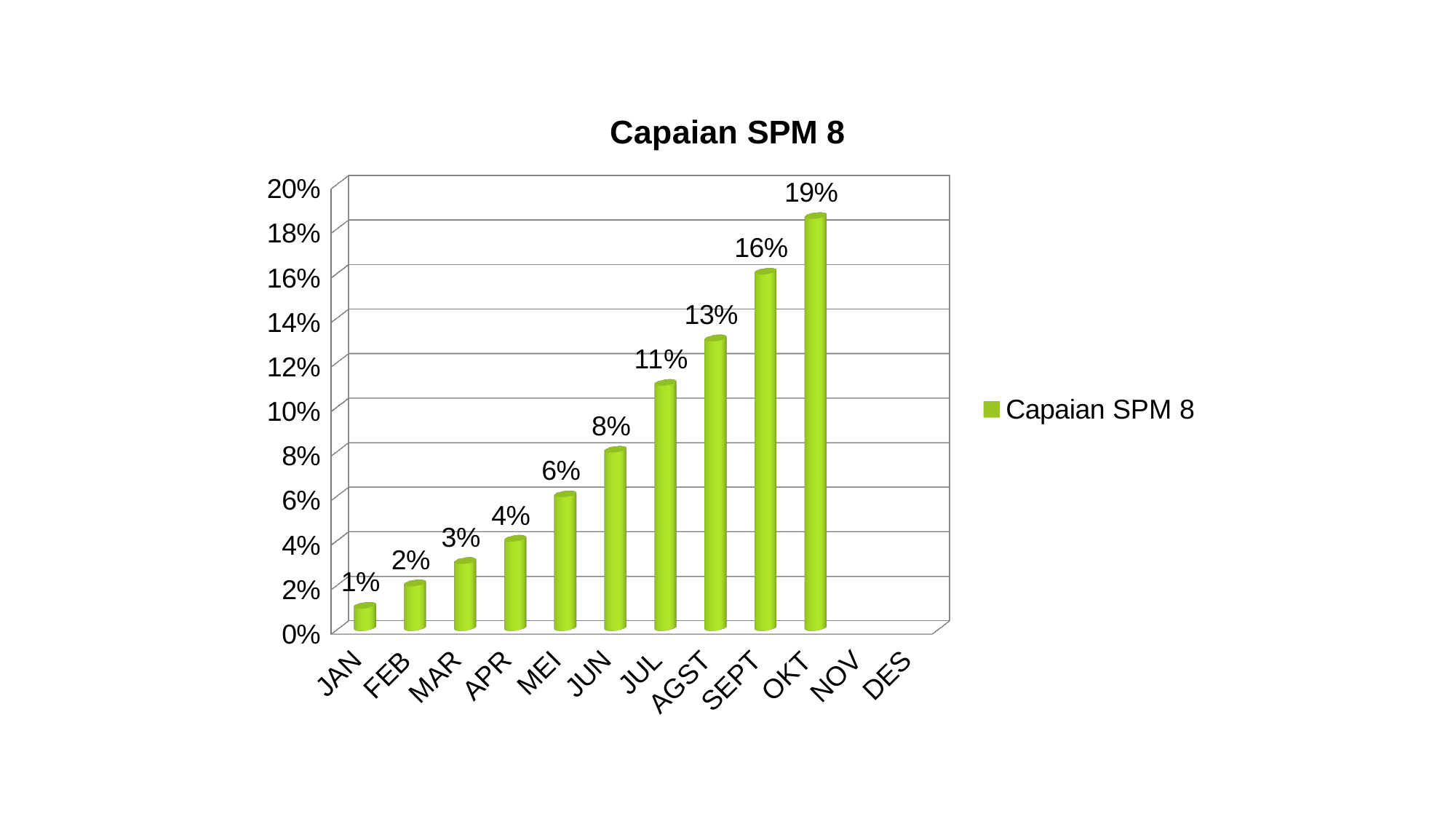
Which is larger, the value for JUN or the value for APR? JUN What is the value for MEI? 6% How many series does the legend list? 1 How many month categories are shown on the x axis? 12 Is the value for AGST greater or less than 10%? greater What is the difference between the values for OKT and AGST? 6% What is the value for JUL? 11% What is the value for SEPT? 16% What kind of chart is shown? bar chart Do the values rise or fall from JAN to OKT? rise Which month with a plotted bar has the lowest value? JAN Which month has the highest value? OKT